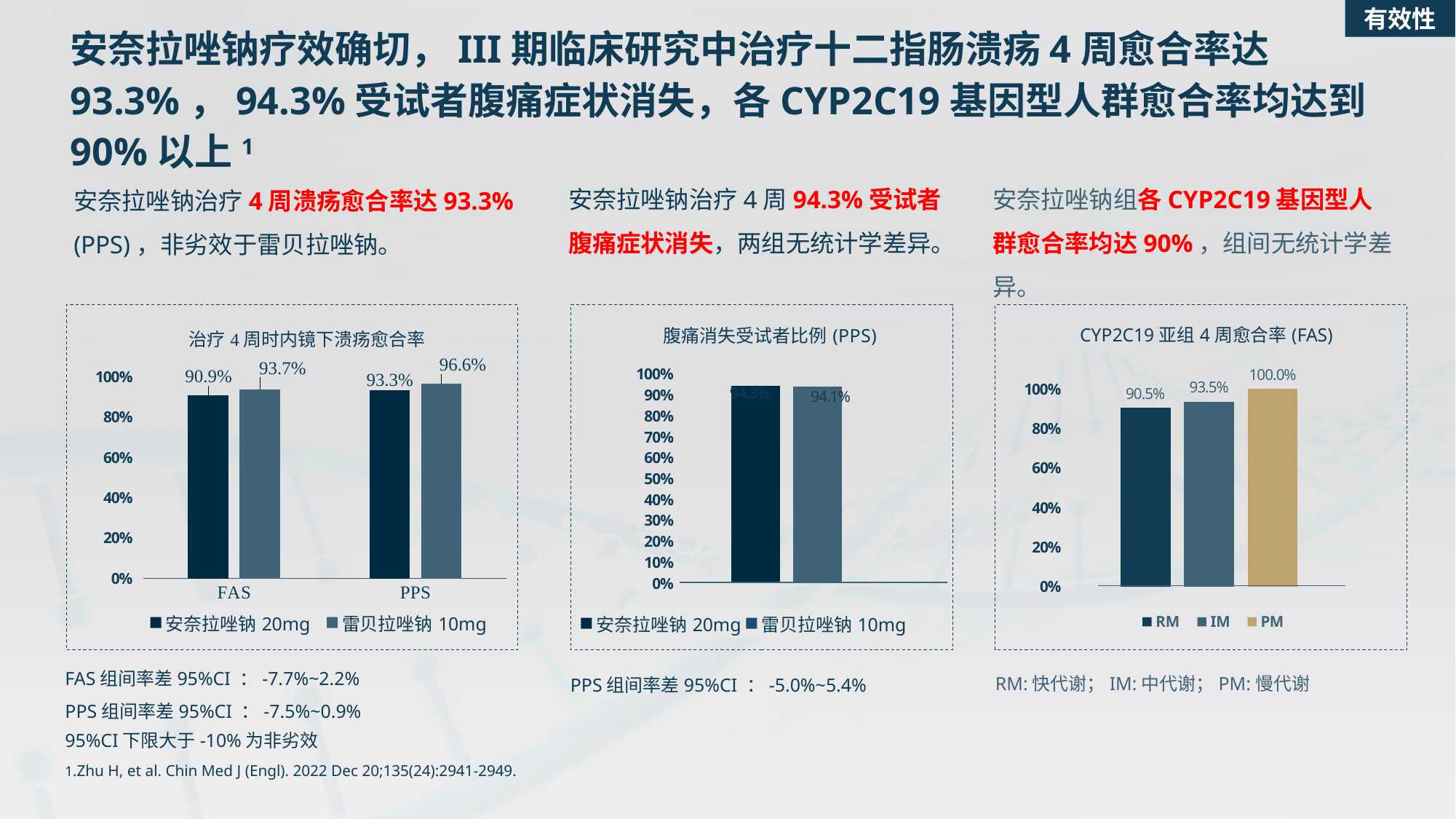
In the chart titled 治疗 4 周时内镜下溃疡愈合率, what is the value for 安奈拉唑钠 20mg in the PPS group? 93.3% In the chart titled 治疗 4 周时内镜下溃疡愈合率, how many categories are shown on the x axis? 2 In the chart titled 腹痛消失受试者比例 (PPS), what kind of chart is shown? Bar chart In the chart titled 治疗 4 周时内镜下溃疡愈合率, what is the value for 雷贝拉唑钠 10mg in the FAS group? 93.7% In the chart titled CYP2C19 亚组 4 周愈合率 (FAS), which subgroup has the lowest healing rate? RM In the chart titled CYP2C19 亚组 4 周愈合率 (FAS), what is the difference between PM and RM? 9.5% In the chart titled 治疗 4 周时内镜下溃疡愈合率, what is the difference between 雷贝拉唑钠 10mg and 安奈拉唑钠 20mg in the PPS group? 3.3% In the chart titled 治疗 4 周时内镜下溃疡愈合率, how many series does the legend list? 2 In the chart titled 腹痛消失受试者比例 (PPS), what is the value for 安奈拉唑钠 20mg? 94.3% In the chart titled CYP2C19 亚组 4 周愈合率 (FAS), which subgroup has the highest healing rate? PM In the chart titled CYP2C19 亚组 4 周愈合率 (FAS), what is the value for IM? 93.5% In the chart titled 腹痛消失受试者比例 (PPS), what is the value for 雷贝拉唑钠 10mg? 94.1%